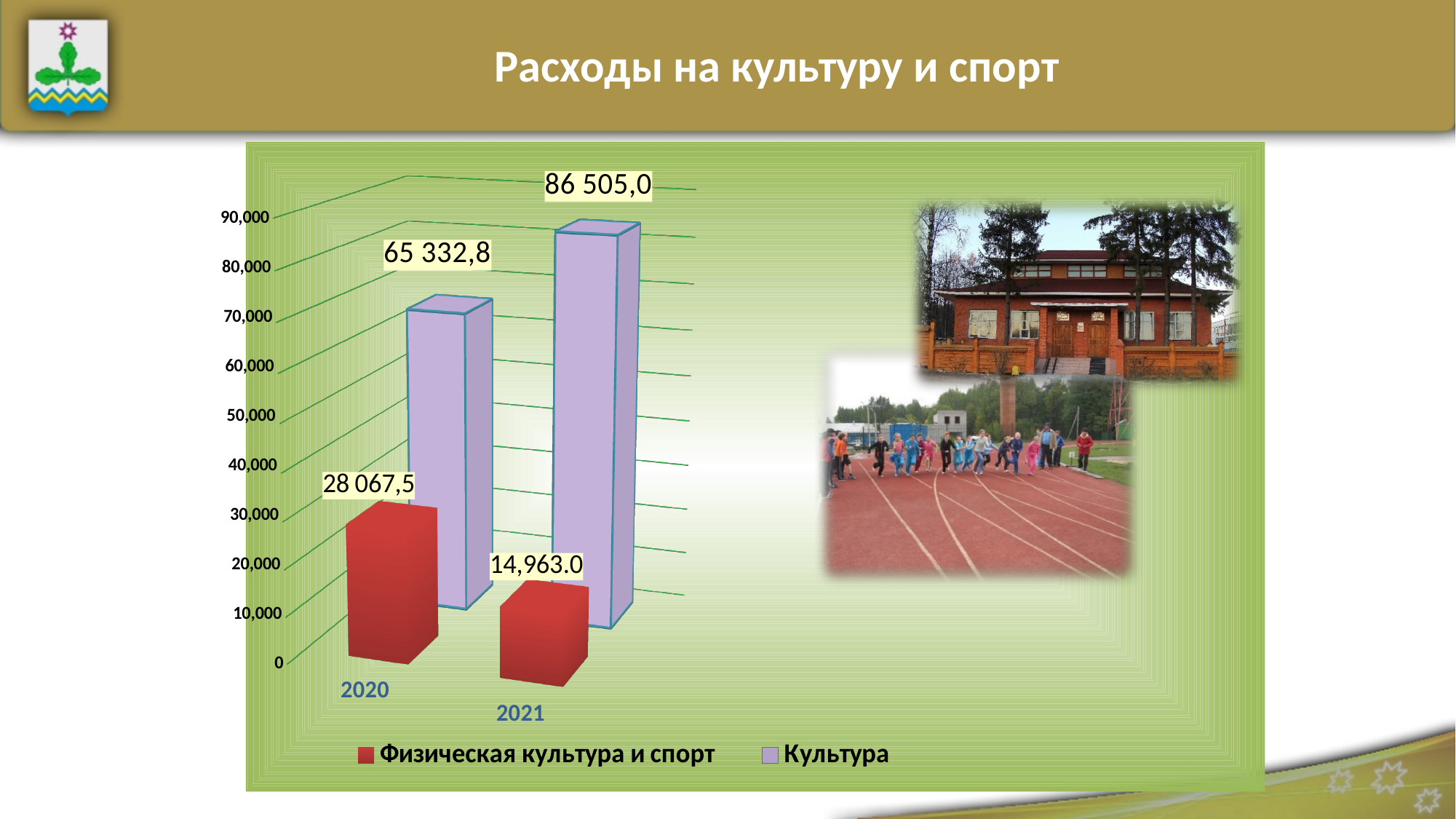
What is the value for Культура in 2020? 65 332,8 What is the title of the slide containing the chart? Расходы на культуру и спорт Which year has the lower value for Физическая культура и спорт? 2021 What is the value for Физическая культура и спорт in 2020? 28 067,5 What kind of chart is shown on the slide? Bar chart What is the value for Культура in 2021? 86 505,0 By how much did the value for Культура increase from 2020 to 2021? 21 172,2 How many series does the legend list? 2 Which year has the higher value for Культура? 2021 By how much did the value for Физическая культура и спорт decrease from 2020 to 2021? 13 104,5 What is the value for Физическая культура и спорт in 2021? 14,963.0 In 2020, which is larger: Культура or Физическая культура и спорт? Культура